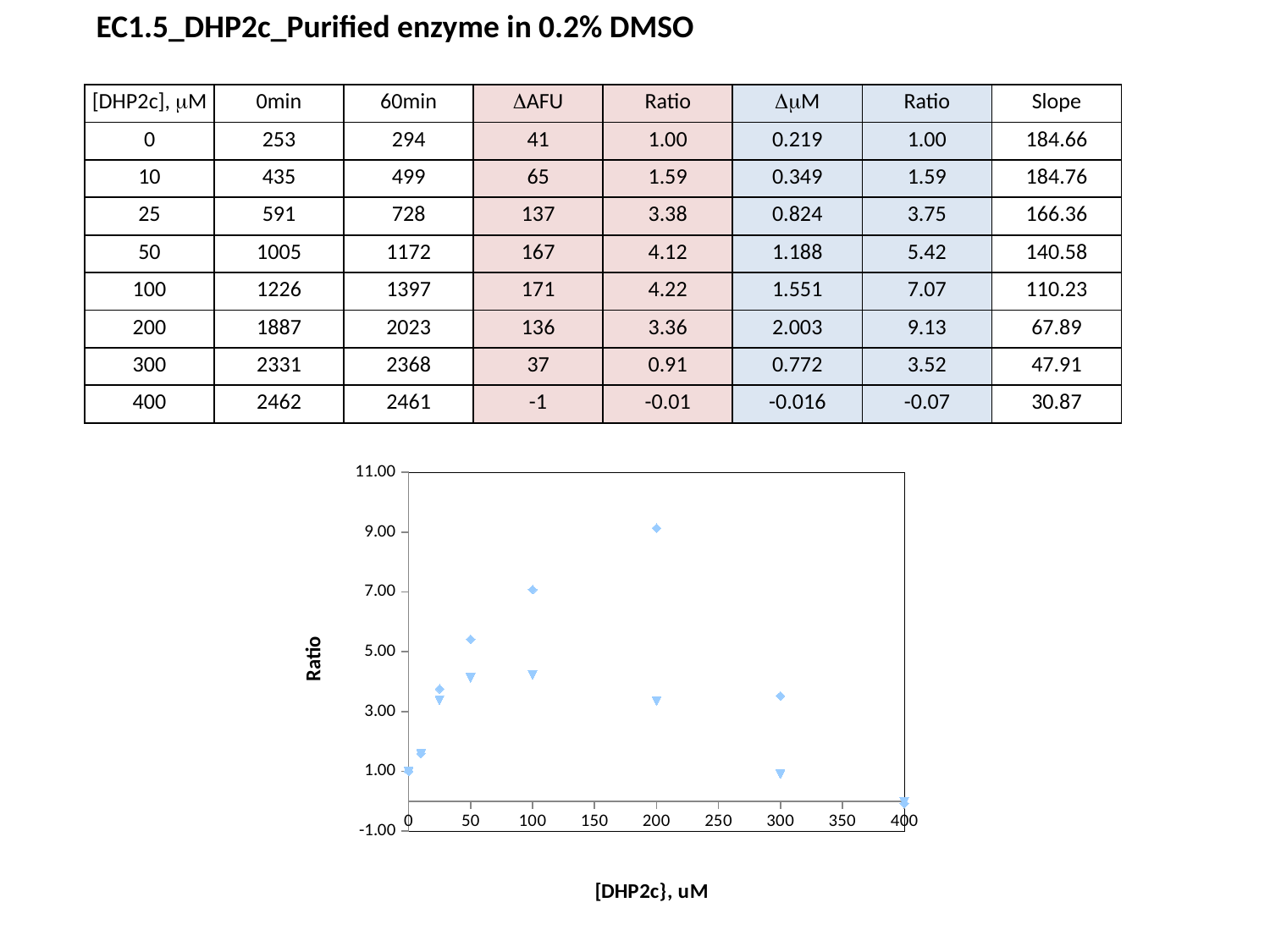
Is the highest point on the chart (at x = 200) greater or less than 7.00? greater What is the title of the y axis of the chart? Ratio Are the points at x = 400 greater or less than 1.00? less At which x-axis value does the highest point on the chart occur? 200 Is the diamond-marker point at x = 100 greater or less than 5.00? greater Does the diamond-marker series rise or fall between x = 0 and x = 200? rise What is the title of the x axis of the chart? [DHP2c}, uM What kind of chart is shown on the slide? scatter chart What is the highest tick value shown on the y axis of the chart? 11.00 How many distinct x-axis positions have plotted points on the chart? 8